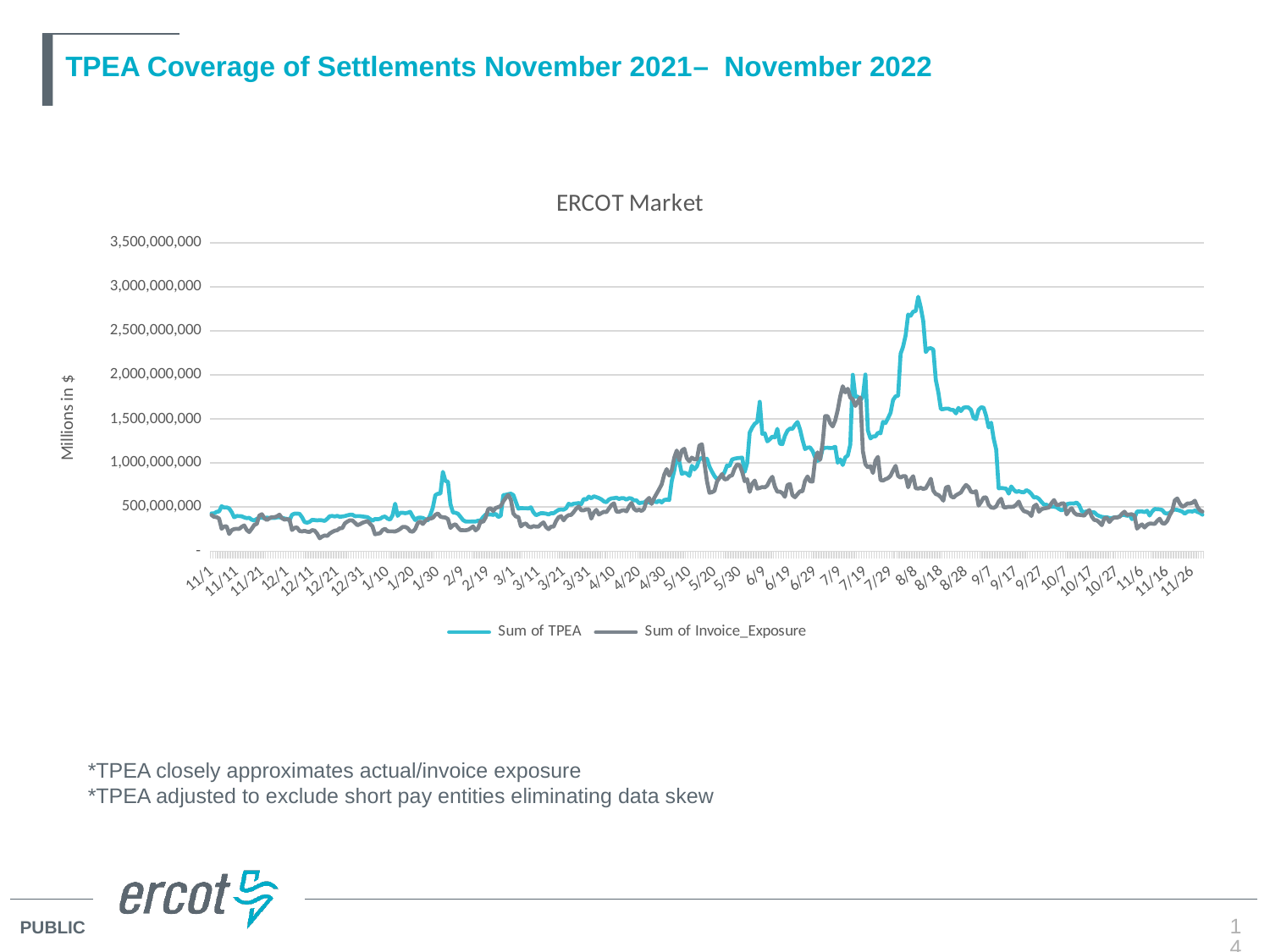
What is the highest value shown on the vertical axis? 3,500,000,000 Is the peak value of Sum of TPEA greater or less than 2,500,000,000? greater Around 6/9, which series is higher, Sum of TPEA or Sum of Invoice_Exposure? Sum of TPEA What is the label on the vertical axis of the chart? Millions in $ How many series does the chart legend list? 2 What kind of chart is shown on the slide? Line chart Around 8/8, which series is higher, Sum of TPEA or Sum of Invoice_Exposure? Sum of TPEA Is the highest value reached by Sum of Invoice_Exposure greater or less than 2,000,000,000? less Is the value of Sum of TPEA at 11/1 greater or less than 1,000,000,000? less Between 8/8 and 9/17, does Sum of TPEA rise or fall? fall What is the title of the chart? ERCOT Market Around which x-axis label does Sum of TPEA reach its highest value? 8/8